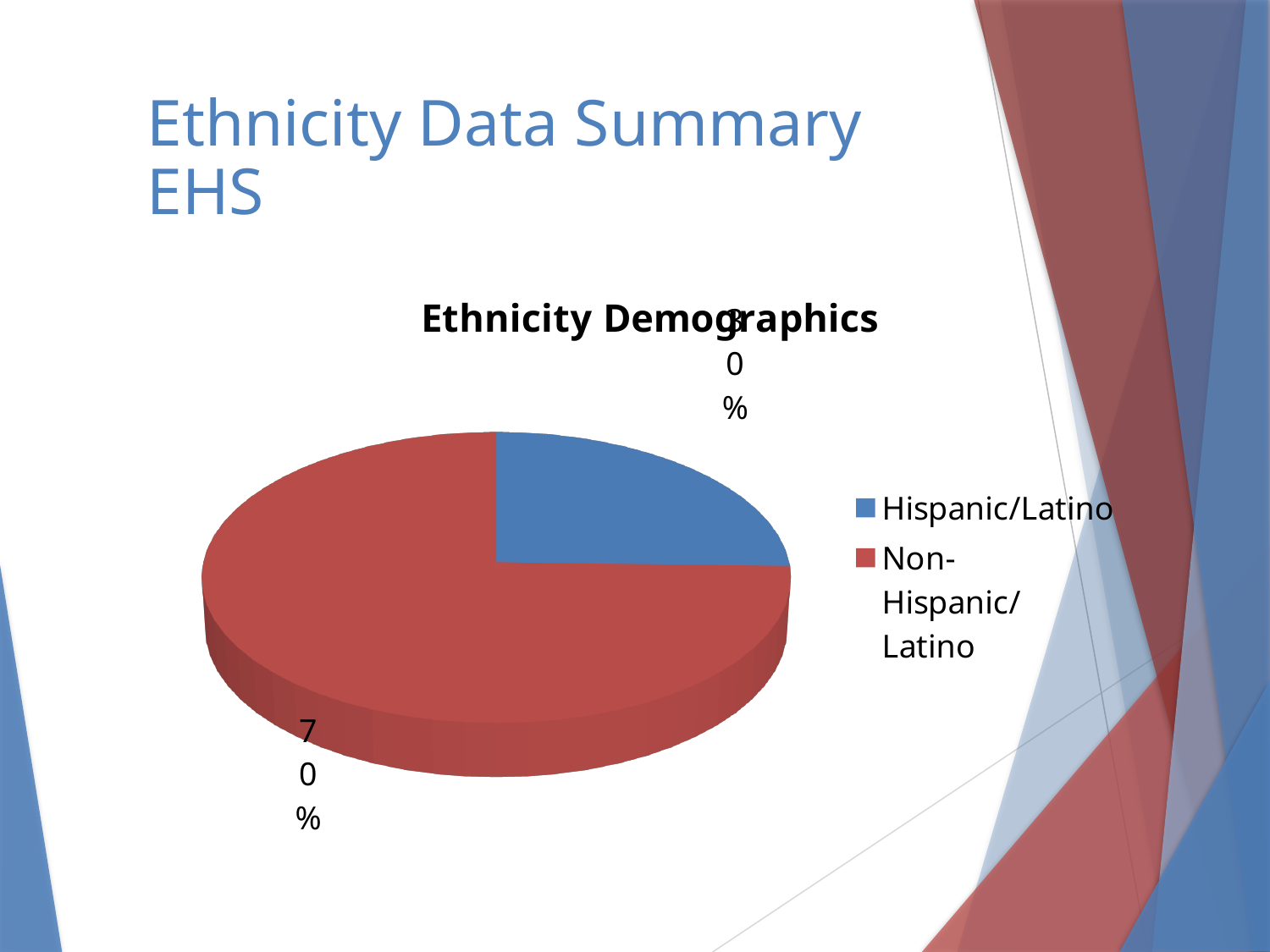
How many entries does the legend list? 2 What colour is the Hispanic/Latino slice? blue What percentage is shown for Non-Hispanic/Latino? 70% What percentage is shown for Hispanic/Latino? 30% How many slices does the pie chart have? 2 Which category has the smallest slice of the pie? Hispanic/Latino What is the title of the chart? Ethnicity Demographics What is the difference in percentage points between the Non-Hispanic/Latino and Hispanic/Latino slices? 40 What share of the pie does Non-Hispanic/Latino represent? 70% Which is larger, the Hispanic/Latino slice or the Non-Hispanic/Latino slice? Non-Hispanic/Latino Which category has the largest slice of the pie? Non-Hispanic/Latino What kind of chart is shown on the slide? pie chart